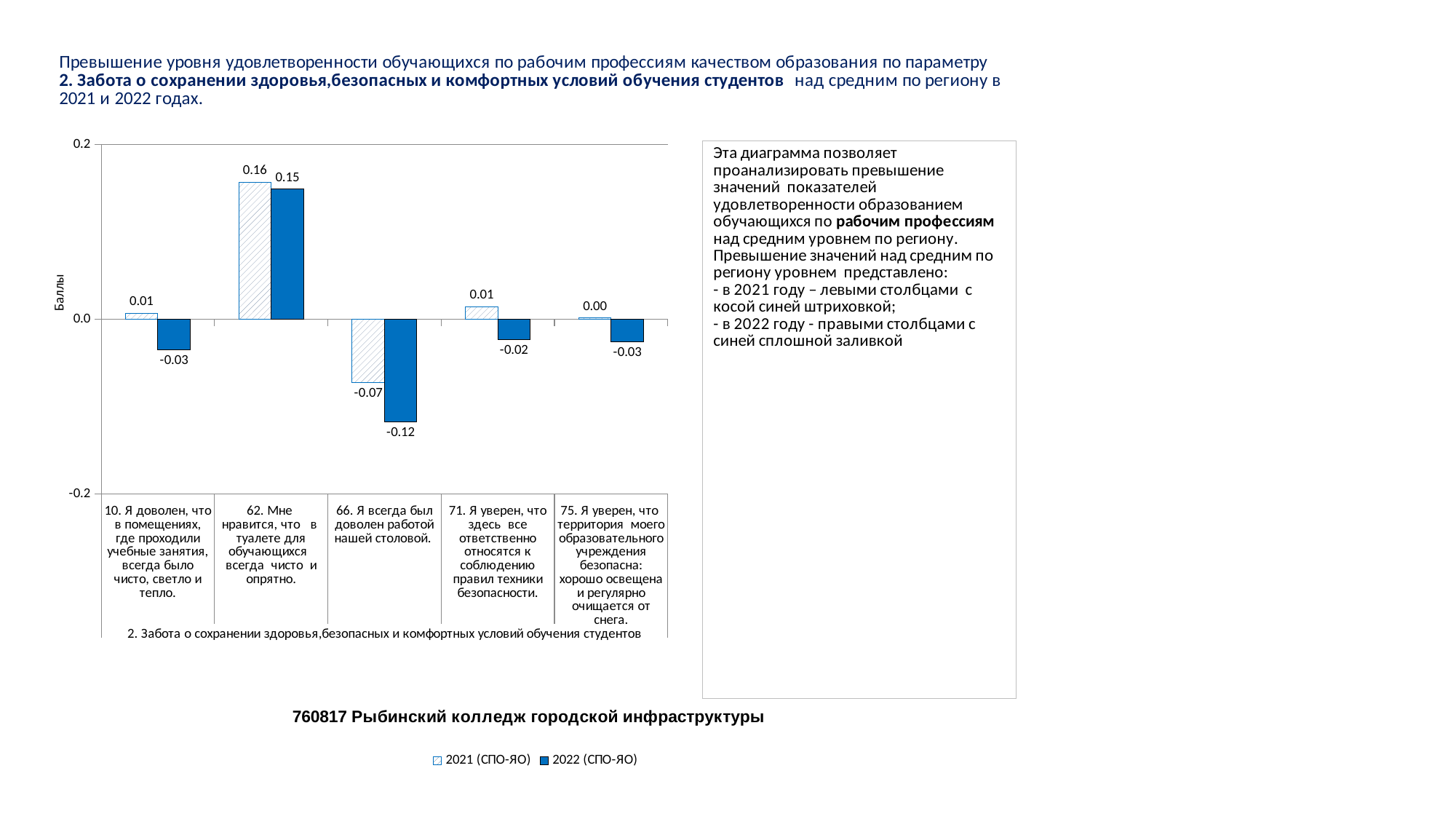
What is the label of the vertical axis of the chart? Баллы How many categories are shown on the x axis of the chart? 5 What is the 2021 (СПО-ЯО) value for category 75 (Я уверен, что территория моего образовательного учреждения безопасна)? 0.00 What is the 2022 (СПО-ЯО) value for category 10 (Я доволен, что в помещениях, где проходили учебные занятия, всегда было чисто, светло и тепло)? -0.03 What is the difference between the 2021 and 2022 values for category 66 (Я всегда был доволен работой нашей столовой)? 0.05 What type of chart is shown on the slide? Bar chart How many series does the chart legend list? 2 Which category has the lowest 2021 (СПО-ЯО) value? 66. Я всегда был доволен работой нашей столовой. What is the 2022 (СПО-ЯО) value for category 66 (Я всегда был доволен работой нашей столовой)? -0.12 For category 62, which series has the larger value: 2021 (СПО-ЯО) or 2022 (СПО-ЯО)? 2021 (СПО-ЯО) Which category has the highest 2022 (СПО-ЯО) value? 62. Мне нравится, что в туалете для обучающихся всегда чисто и опрятно. What is the 2021 (СПО-ЯО) value for category 62 (Мне нравится, что в туалете для обучающихся всегда чисто и опрятно)? 0.16